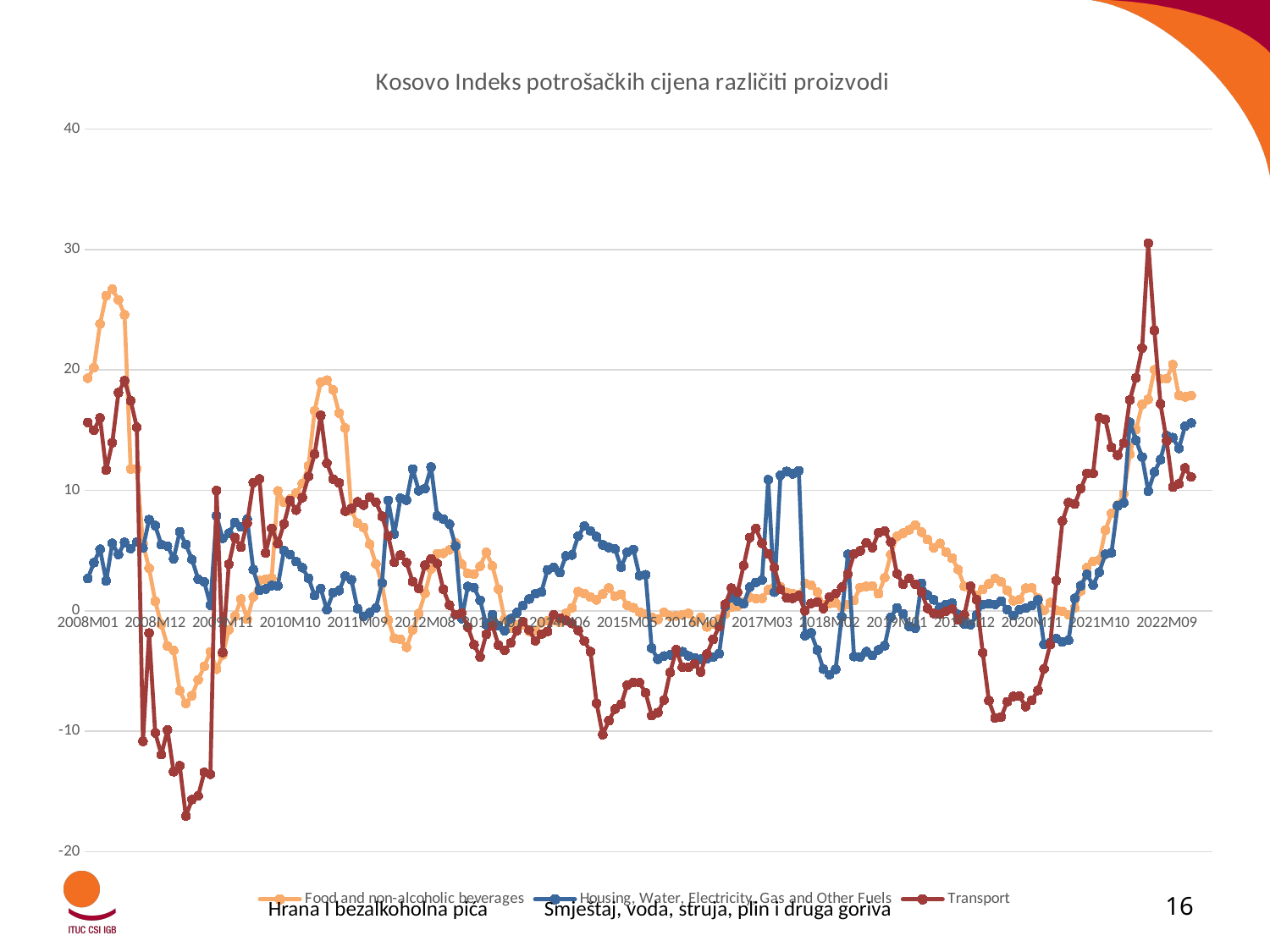
Is the peak value of the Transport series in 2022 greater or less than 20? greater What is the title of the chart? Kosovo Indeks potrošačkih cijena različiti proizvodi How many series does the legend list? 3 Is the highest value of the Housing, Water, Electricity, Gas and Other Fuels series greater or less than 20? less Which series is drawn in dark red? Transport What kind of chart is shown on the slide? line chart Which series reaches the lowest value anywhere on the chart? Transport Does the Transport series rise or fall between 2020M11 and its 2022 peak? rise Is the peak value of the Food and non-alcoholic beverages series in 2008 greater or less than 20? greater What is the first label on the x axis? 2008M01 Which series reaches the highest value anywhere on the chart? Transport